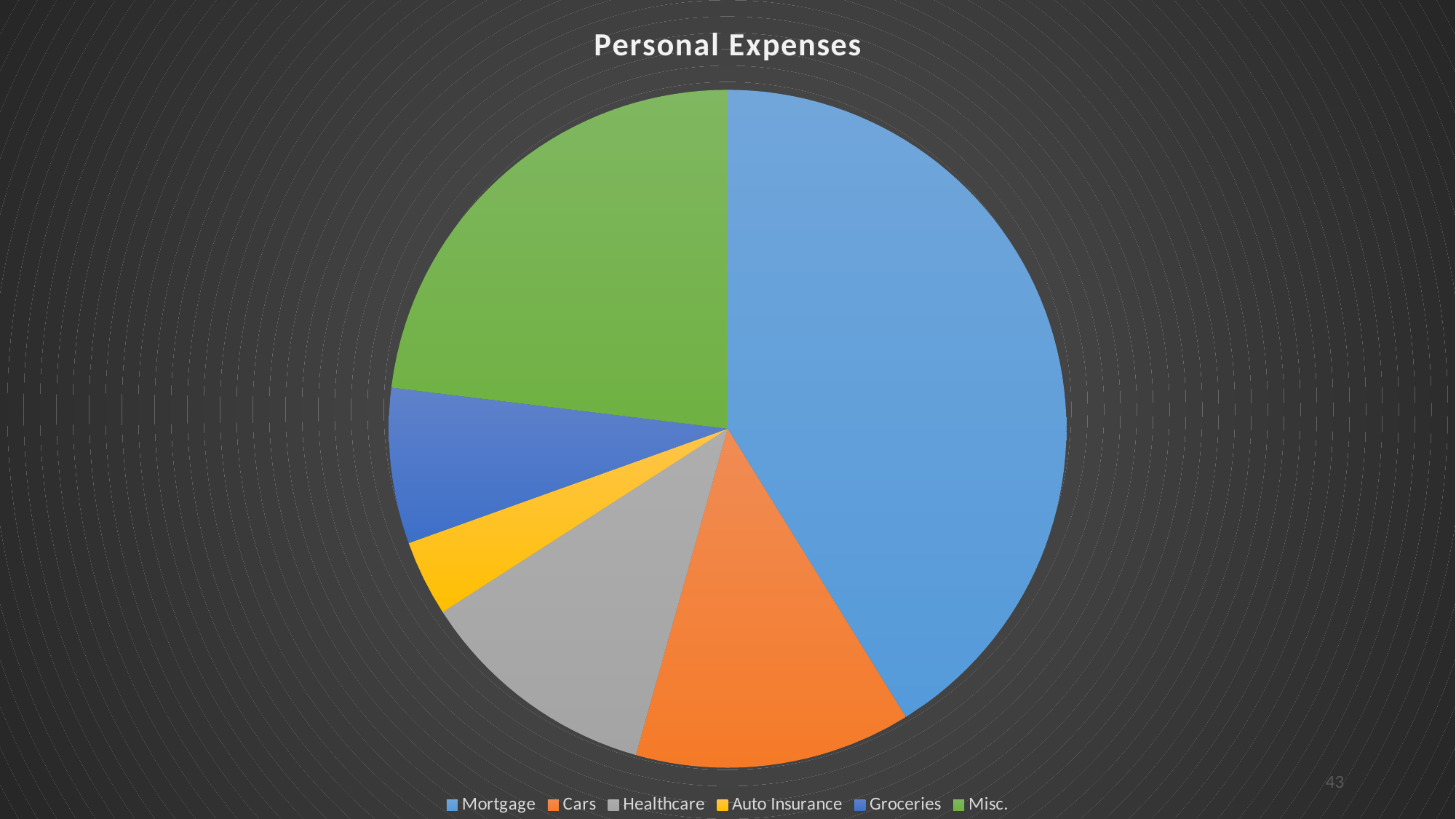
What colour is the Misc. slice in the pie chart? green How many categories (slices) does the pie chart have? 6 What is the title of the chart? Personal Expenses What kind of chart is shown on the slide? pie chart Which slice is larger, Mortgage or Cars? Mortgage Which slice is larger, Misc. or Groceries? Misc. Which slice is larger, Misc. or Cars? Misc. Which category has the largest slice of the pie? Mortgage Which category has the smallest slice of the pie? Auto Insurance